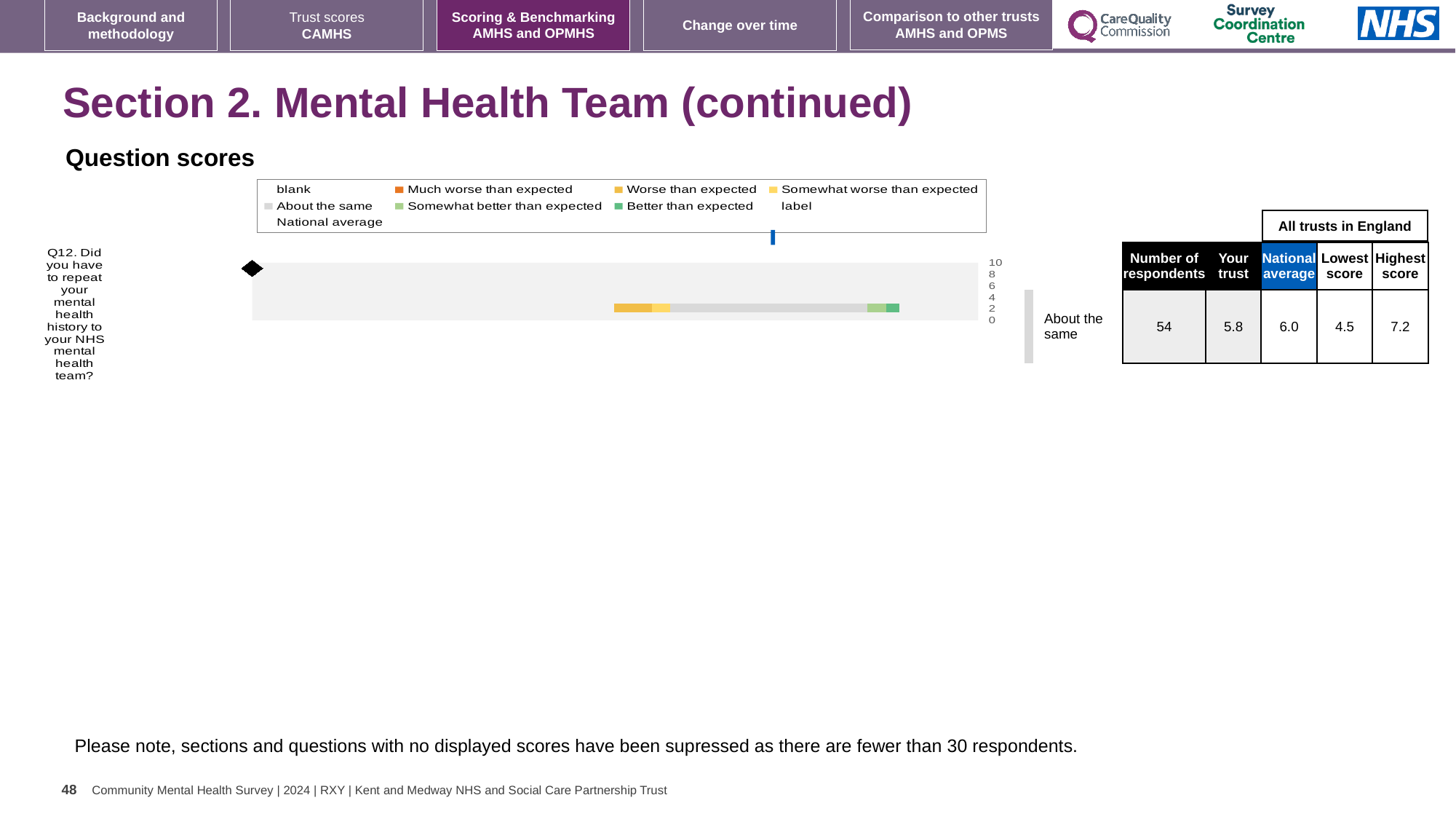
What kind of chart is used to show the question scores? bar chart How many respondents answered Q12? 54 What is the lowest score among all trusts in England for Q12? 4.5 What is the difference between the highest score and the lowest score for Q12? 2.7 What is the highest score among all trusts in England for Q12? 7.2 What is the 'Your trust' score for Q12 (Did you have to repeat your mental health history to your NHS mental health team?)? 5.8 What is the national average score shown for Q12? 6.0 Is the trust's score for Q12 higher or lower than the national average? lower Which benchmarking category is the trust's Q12 score placed in? About the same What is the difference between the national average and the trust's score for Q12? 0.2 Is the trust's score for Q12 greater or less than 6? less How many questions are plotted in the question scores chart? 1